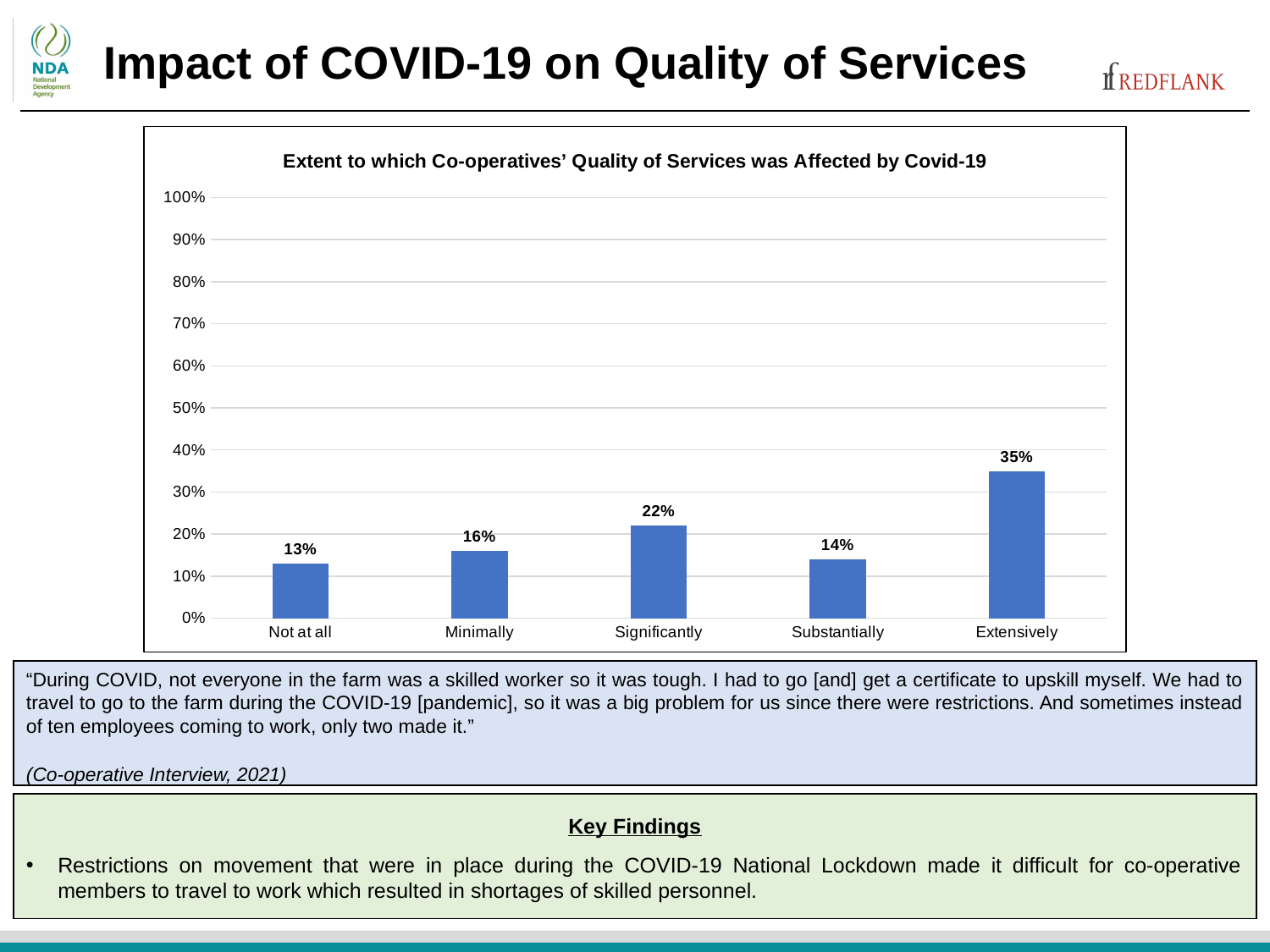
What is the value shown for the 'Not at all' category? 13% Which category has the lowest value in the chart? Not at all What is the title of the chart? Extent to which Co-operatives' Quality of Services was Affected by Covid-19 What kind of chart is shown on the slide? Bar chart How many categories are shown on the x axis of the chart? 5 Is the value for 'Extensively' greater or less than 30%? greater What is the value shown for the 'Significantly' category? 22% What is the difference between the 'Minimally' and 'Substantially' values? 2% Which category has the highest value in the chart? Extensively What percentage of co-operatives reported their quality of services was affected 'Extensively' by Covid-19? 35% Which is larger, the value for 'Significantly' or the value for 'Substantially'? Significantly What is the difference between the 'Extensively' and 'Significantly' values? 13%